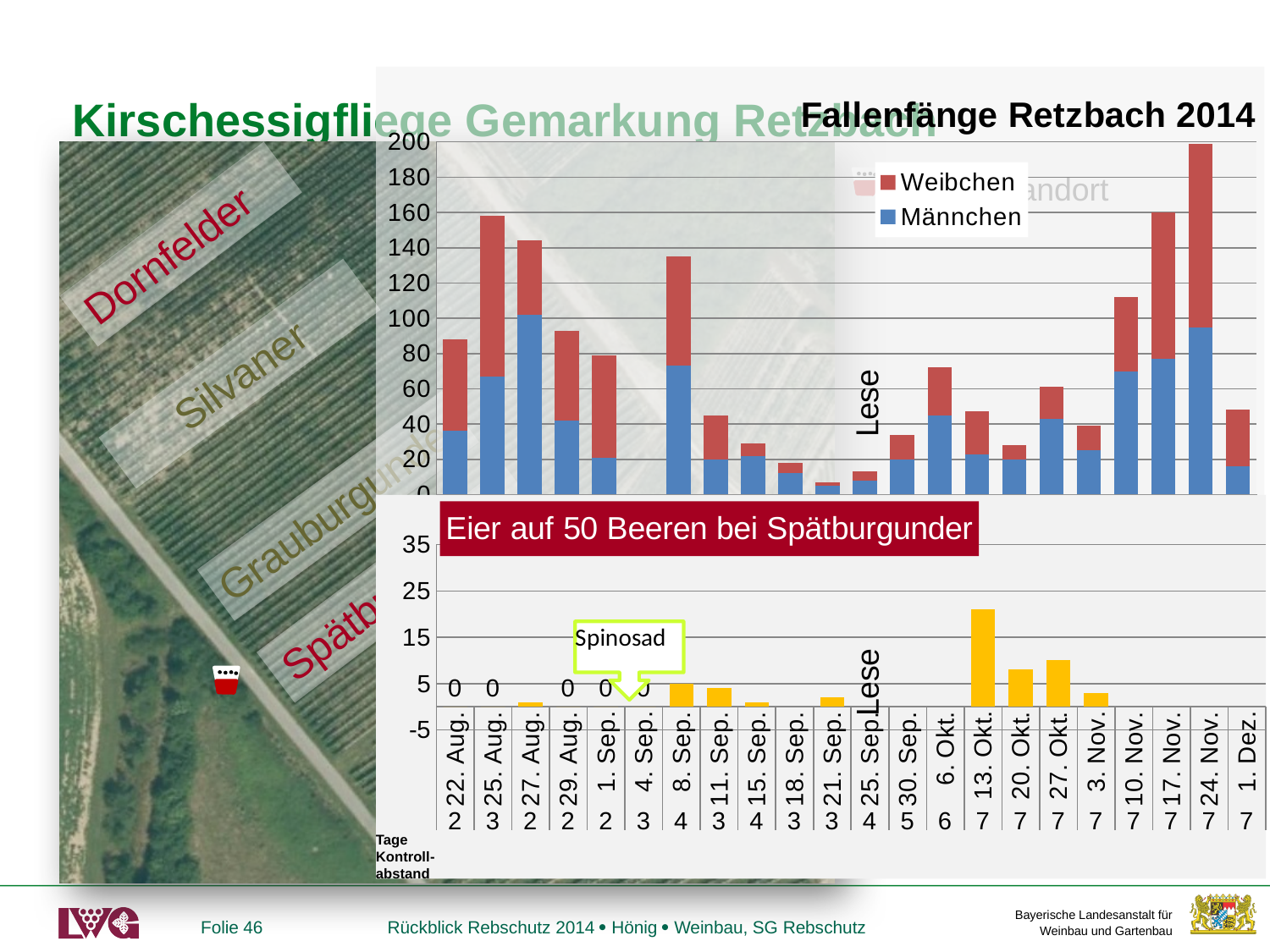
What kind of chart is the "Eier auf 50 Beeren bei Spätburgunder" chart? bar chart How many series does the legend of the "Fallenfänge Retzbach 2014" chart list? 2 Which two series are listed in the legend of the "Fallenfänge Retzbach 2014" chart? Weibchen and Männchen In the "Fallenfänge Retzbach 2014" chart, is the total bar for 25. Aug. greater or less than 140? greater What is the title of the lower chart on the slide? Eier auf 50 Beeren bei Spätburgunder In the "Fallenfänge Retzbach 2014" chart, which stacked bar is taller: 10. Nov. or 3. Nov.? 10. Nov. In the "Fallenfänge Retzbach 2014" chart, which date has the tallest stacked bar? 24. Nov. What kind of chart is the "Fallenfänge Retzbach 2014" chart? bar chart In the "Fallenfänge Retzbach 2014" chart, is the total bar for 21. Sep. greater or less than 20? less In the "Eier auf 50 Beeren bei Spätburgunder" chart, what is the value for 22. Aug.? 0 How many dates are shown on the x axis of the "Eier auf 50 Beeren bei Spätburgunder" chart? 22 In the "Eier auf 50 Beeren bei Spätburgunder" chart, which date has the highest value? 13. Okt.